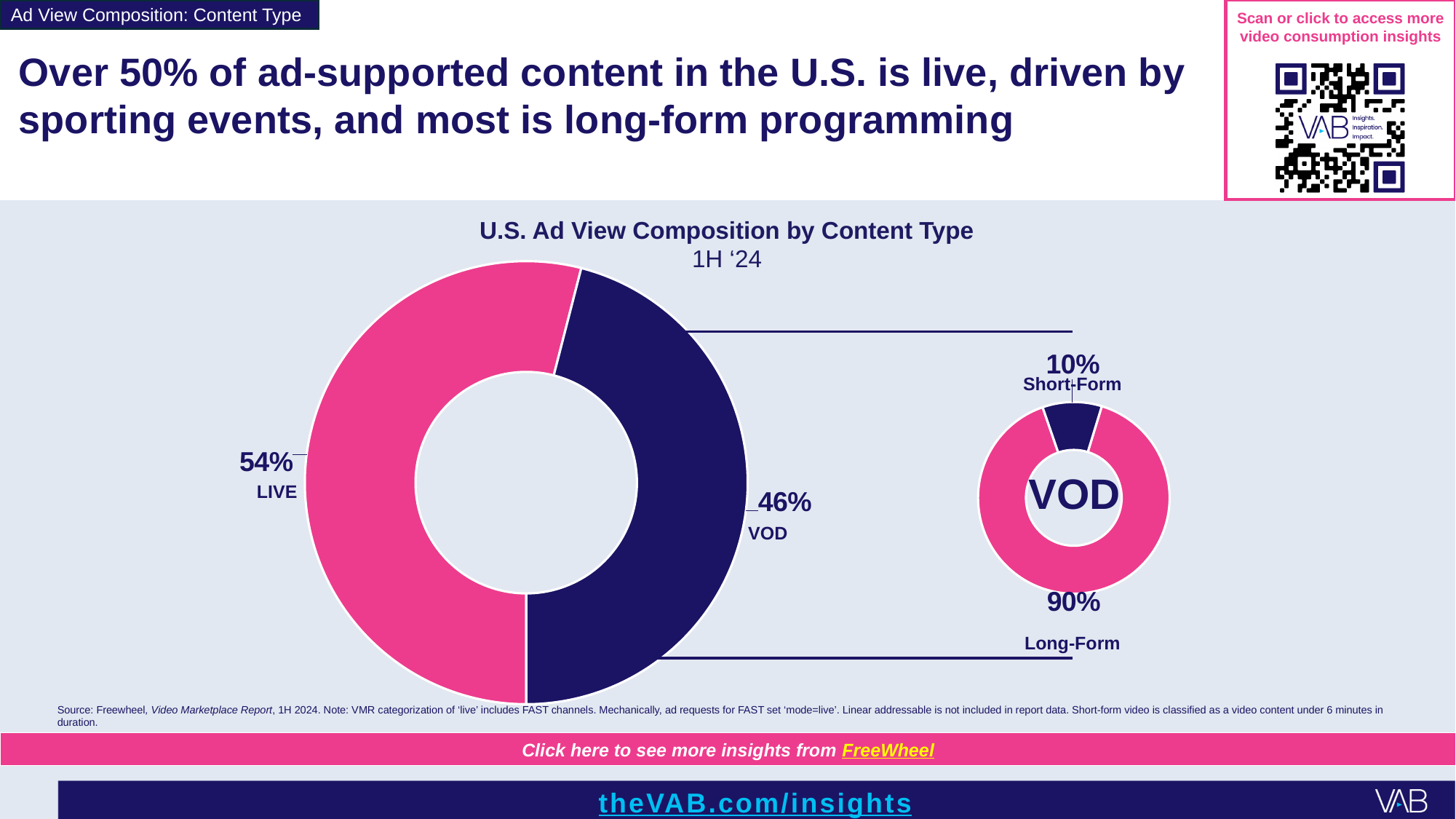
In the small VOD donut chart, which segment is the smallest? Short-Form In the large donut chart, what share of U.S. ad views is LIVE content? 54% In the large donut chart, which content type has the larger share, LIVE or VOD? LIVE In the small VOD donut chart, which segment is the largest? Long-Form In the small VOD donut chart, what is the difference in percentage points between Long-Form and Short-Form? 80 percentage points In the small VOD donut chart, what share is Long-Form? 90% How many segments does the large donut chart have? 2 What time period does the large donut chart's subtitle indicate? 1H '24 What type of chart is used to show the U.S. Ad View Composition by Content Type? Donut (pie) chart In the large donut chart, what is the difference in percentage points between the LIVE and VOD shares? 8 percentage points In the small VOD donut chart, what share is Short-Form? 10% In the large donut chart, what share of U.S. ad views is VOD content? 46%